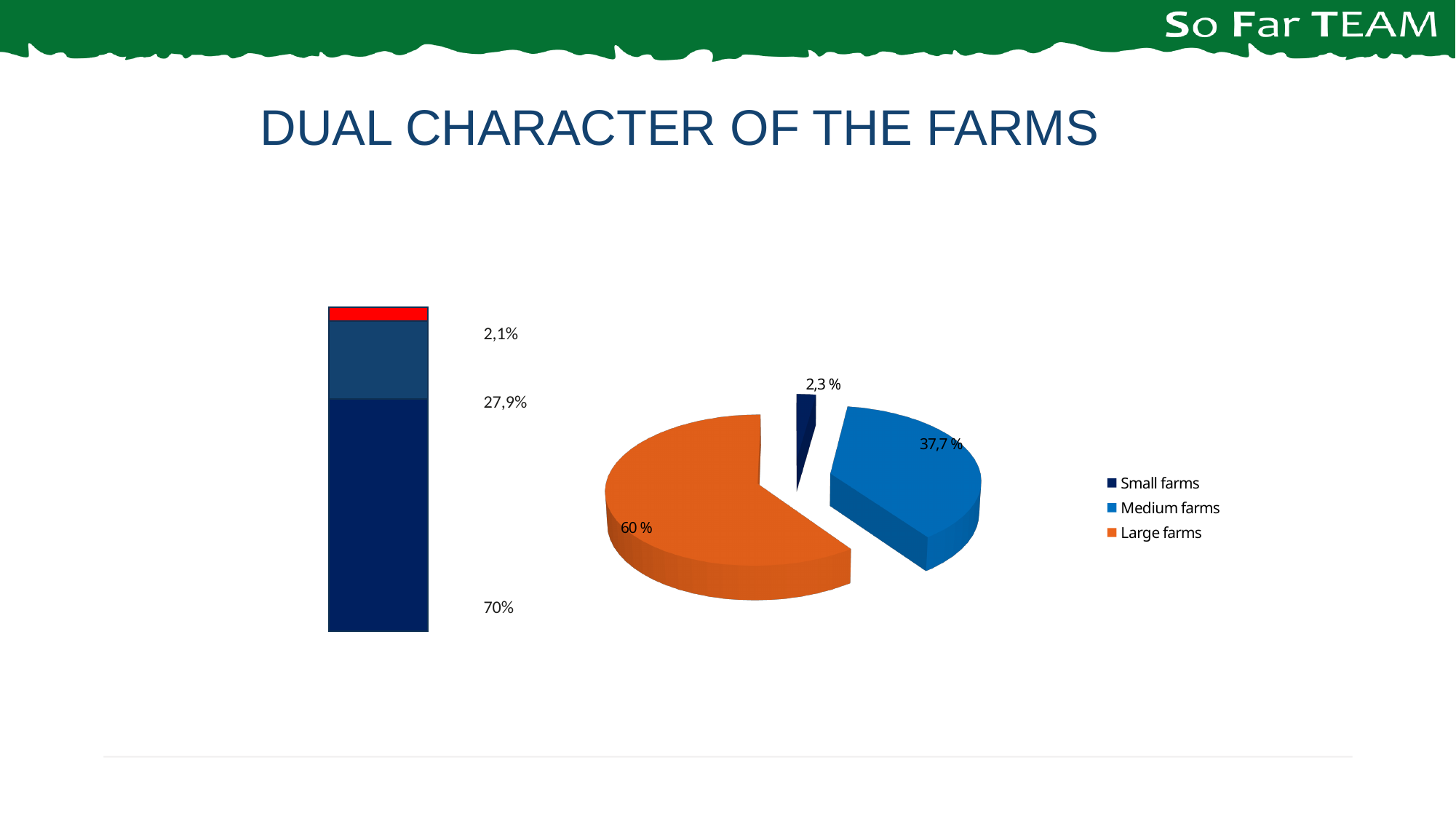
How many entries does the legend of the pie chart on the right list? 3 In the pie chart on the right, which is larger: the share of Medium farms or the share of Small farms? Medium farms In the pie chart on the right, which category has the largest slice? Large farms In the pie chart on the right, what share do Small farms have? 2,3 % In the pie chart on the right, which category has the smallest slice? Small farms How many segments does the stacked bar on the left of the slide have? 3 What kind of chart is shown on the right of the slide? Pie chart What kind of chart is shown on the left of the slide? Bar chart In the pie chart on the right, what is the difference between the shares of Large farms and Medium farms? 22,3 % In the pie chart on the right, what share do Large farms have? 60 % In the pie chart on the right, what share do Medium farms have? 37,7 % What is the total of the three segments of the stacked bar on the left of the slide? 100%